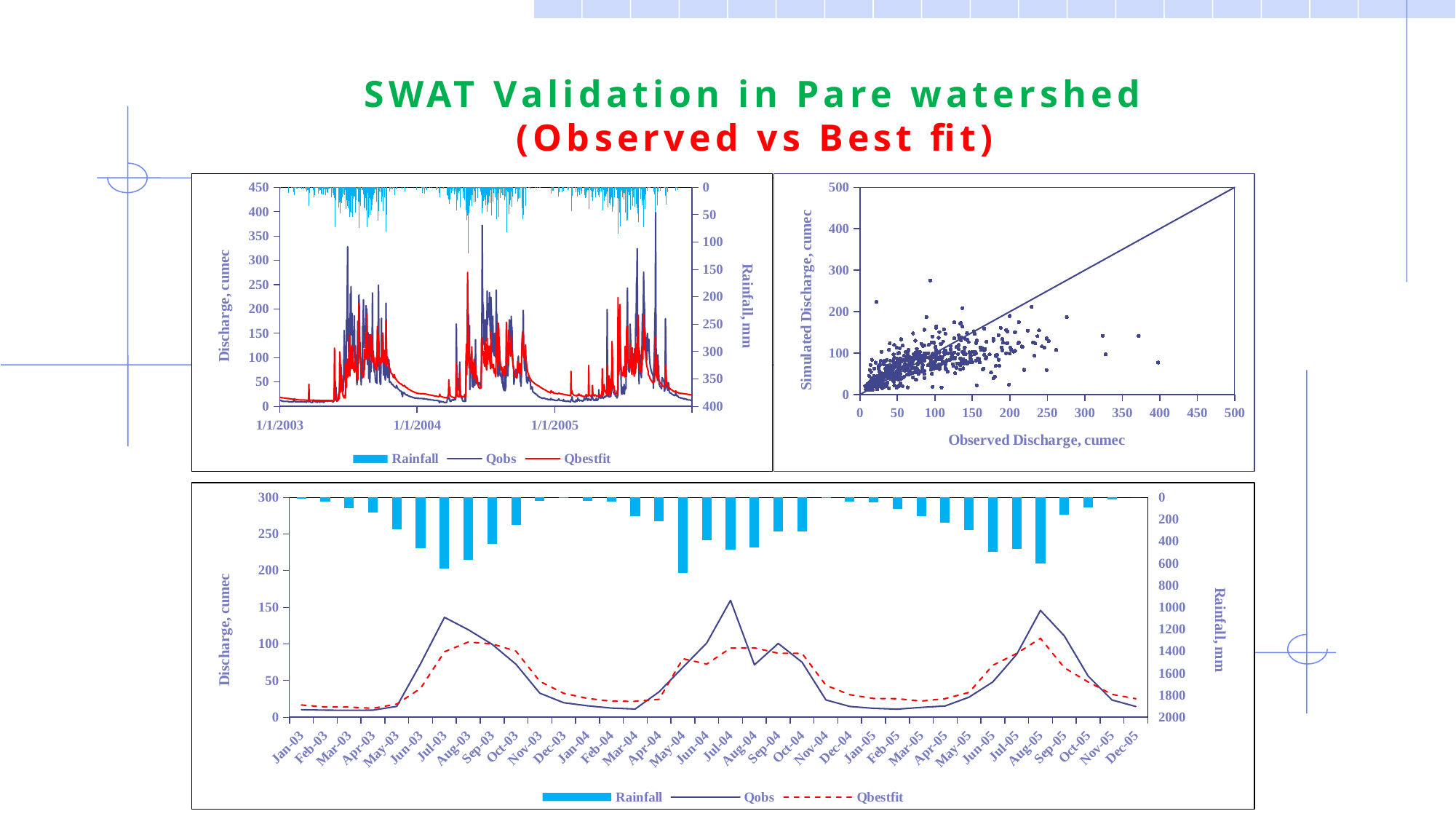
In the bottom chart, is the Qobs value for Jul-04 greater or less than 100? greater In the top-right chart, what is the highest value shown on the x axis? 500 What kind of chart is the top-right chart? scatter chart In the top-left chart, what are the legend entries? Rainfall, Qobs, Qbestfit In the top-right chart, what is the title of the x axis? Observed Discharge, cumec In the bottom chart, is the Qobs value for Jul-03 greater or less than 100? greater In the bottom chart, does the Qobs line rise or fall from Jul-03 to Dec-03? fall In the bottom chart, which is larger in Jul-04, Qobs or Qbestfit? Qobs In the bottom chart, which is larger in Aug-04, Qobs or Qbestfit? Qbestfit In the bottom chart, is the Qbestfit value for Jan-03 greater or less than 50? less In the bottom chart, how many series does the legend list? 3 In the bottom chart, how many months are labelled on the x axis? 36